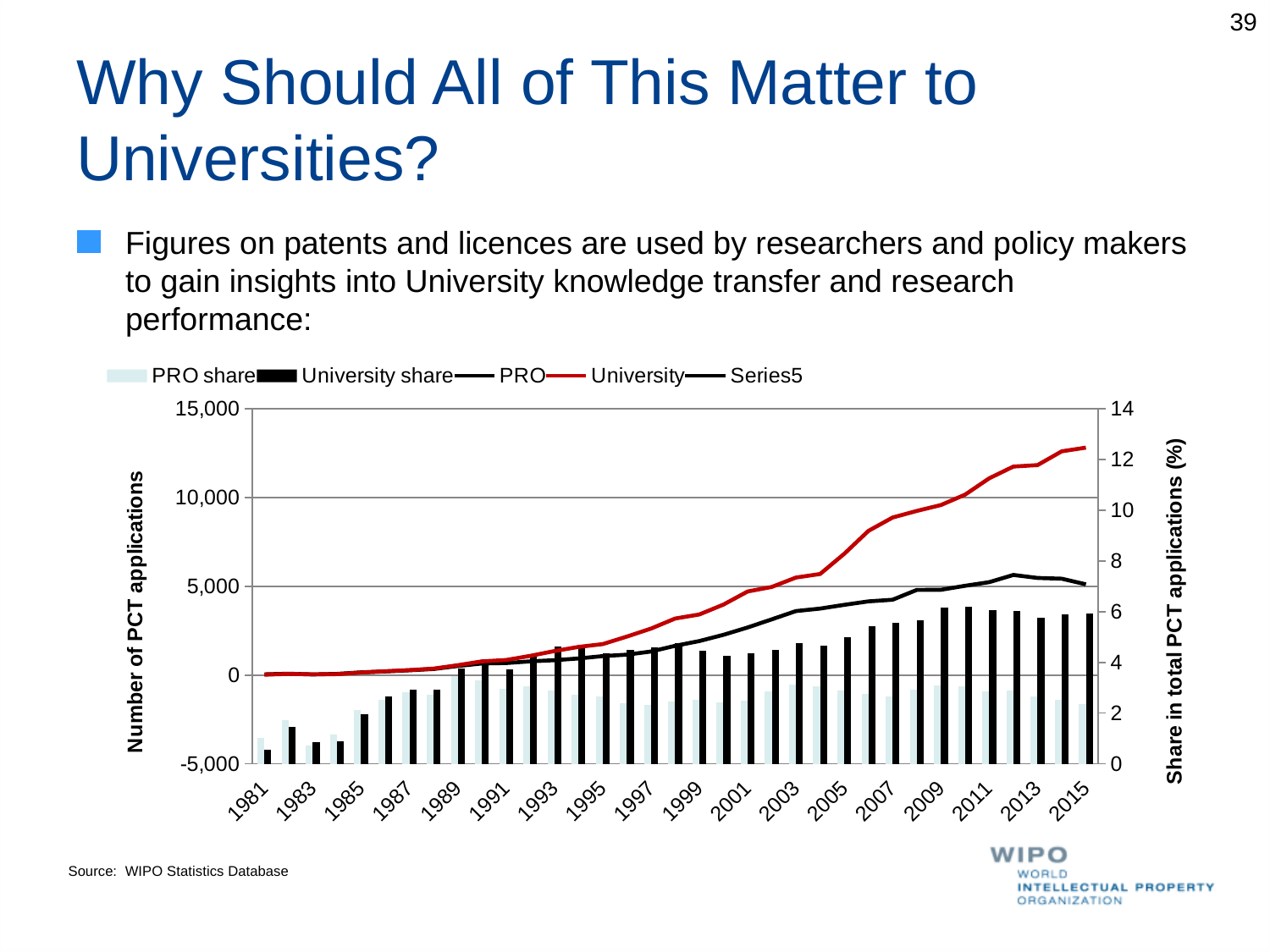
What kind of chart is shown on the slide? A combined bar and line chart What is the first year shown on the x axis? 1981 What is the title of the right vertical axis? Share in total PCT applications (%) How many series does the chart legend list? 5 What is the title of the left vertical axis? Number of PCT applications In 2015, which line is higher, University or PRO? University What is the last year shown on the x axis? 2015 Does the University line rise or fall from 1981 to 2015? Rise In which year does the University line reach its highest value? 2015